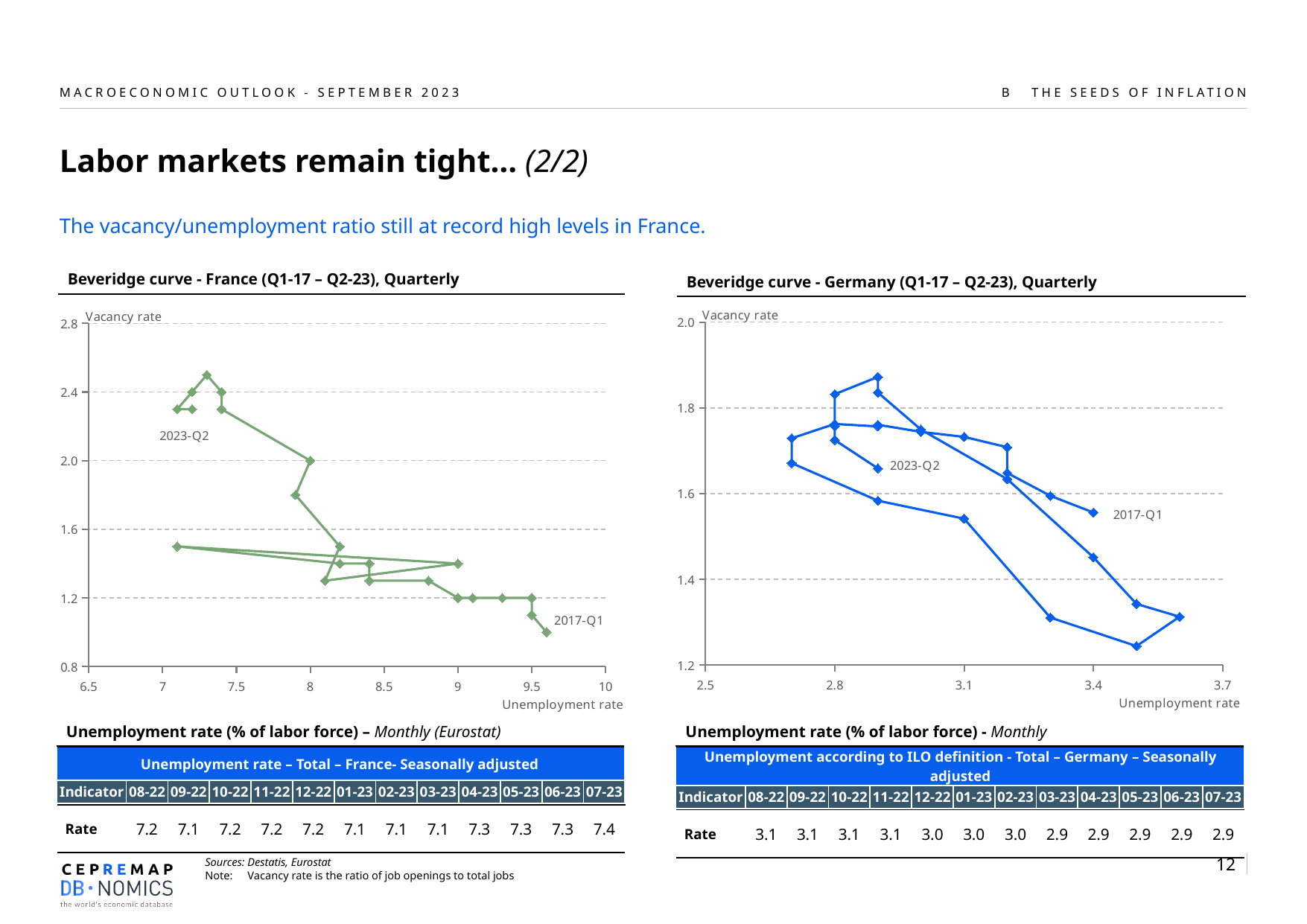
On the Beveridge curve - France chart, is the unemployment rate at the 2017-Q1 point greater or less than 9? greater On the Beveridge curve - France chart, is the vacancy rate at the 2017-Q1 point greater or less than 1.2? less On the Beveridge curve - France chart, is the unemployment rate at the 2023-Q2 point greater or less than 7.5? less On the Beveridge curve - Germany chart, which point has the higher unemployment rate, 2017-Q1 or 2023-Q2? 2017-Q1 What variable is plotted on the vertical axis of the Beveridge curve - Germany chart? Vacancy rate On the Beveridge curve - France chart, which point has the higher vacancy rate, 2017-Q1 or 2023-Q2? 2023-Q2 What colour is the line in the Beveridge curve - France chart? green What kind of chart is the Beveridge curve for France? line chart